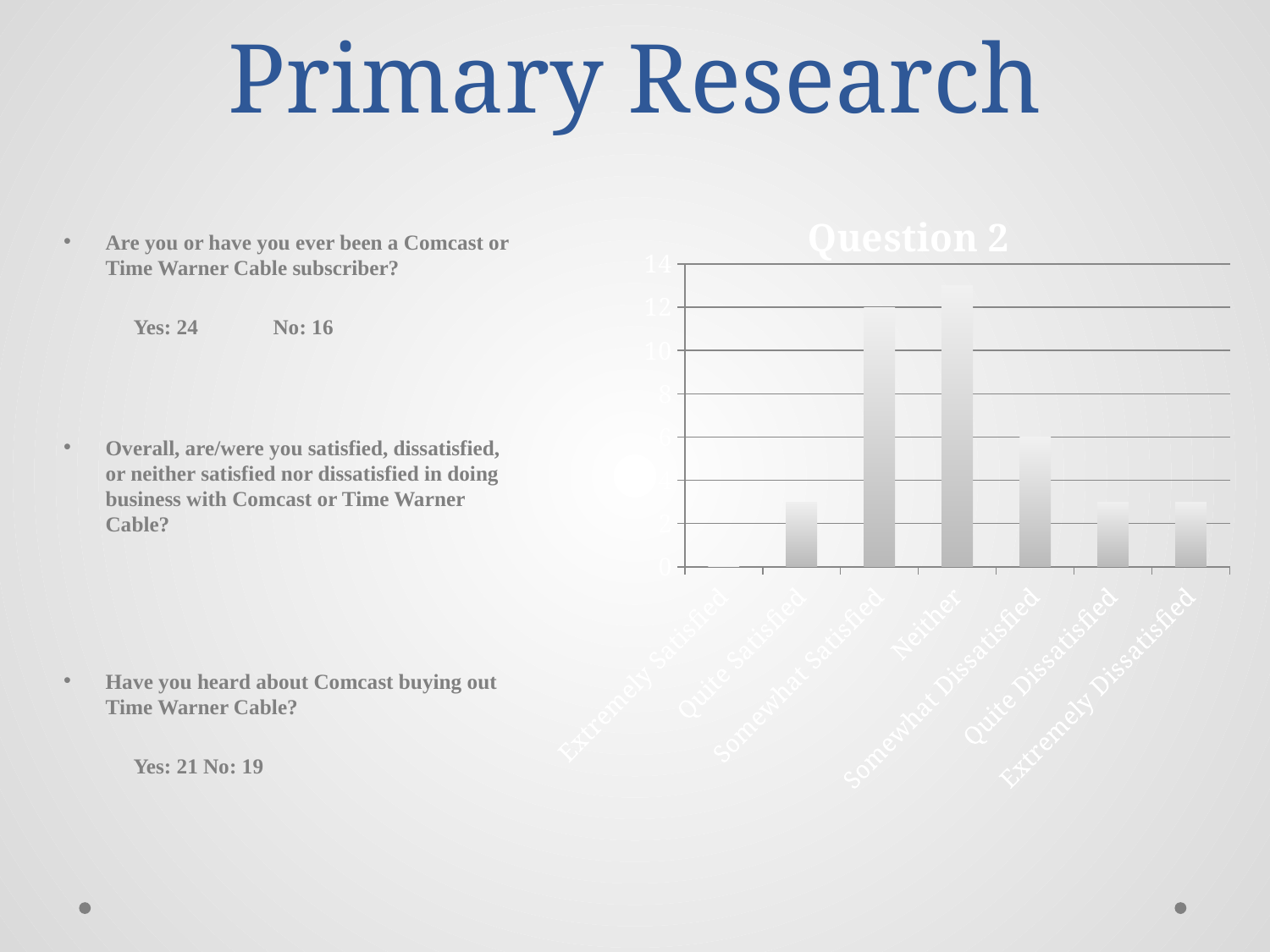
What kind of chart is shown on the slide? bar chart Is the value for Extremely Dissatisfied greater or less than 2? greater Which is larger, the value for Somewhat Satisfied or the value for Somewhat Dissatisfied? Somewhat Satisfied Which is larger, the value for Neither or the value for Quite Satisfied? Neither Is the value for Quite Dissatisfied greater or less than 4? less Which category has the highest value in the chart? Neither Is the value for Neither greater or less than 12? greater How many categories are shown on the x axis of the chart? 7 What is the title of the chart? Question 2 Which category has the lowest value in the chart? Extremely Satisfied